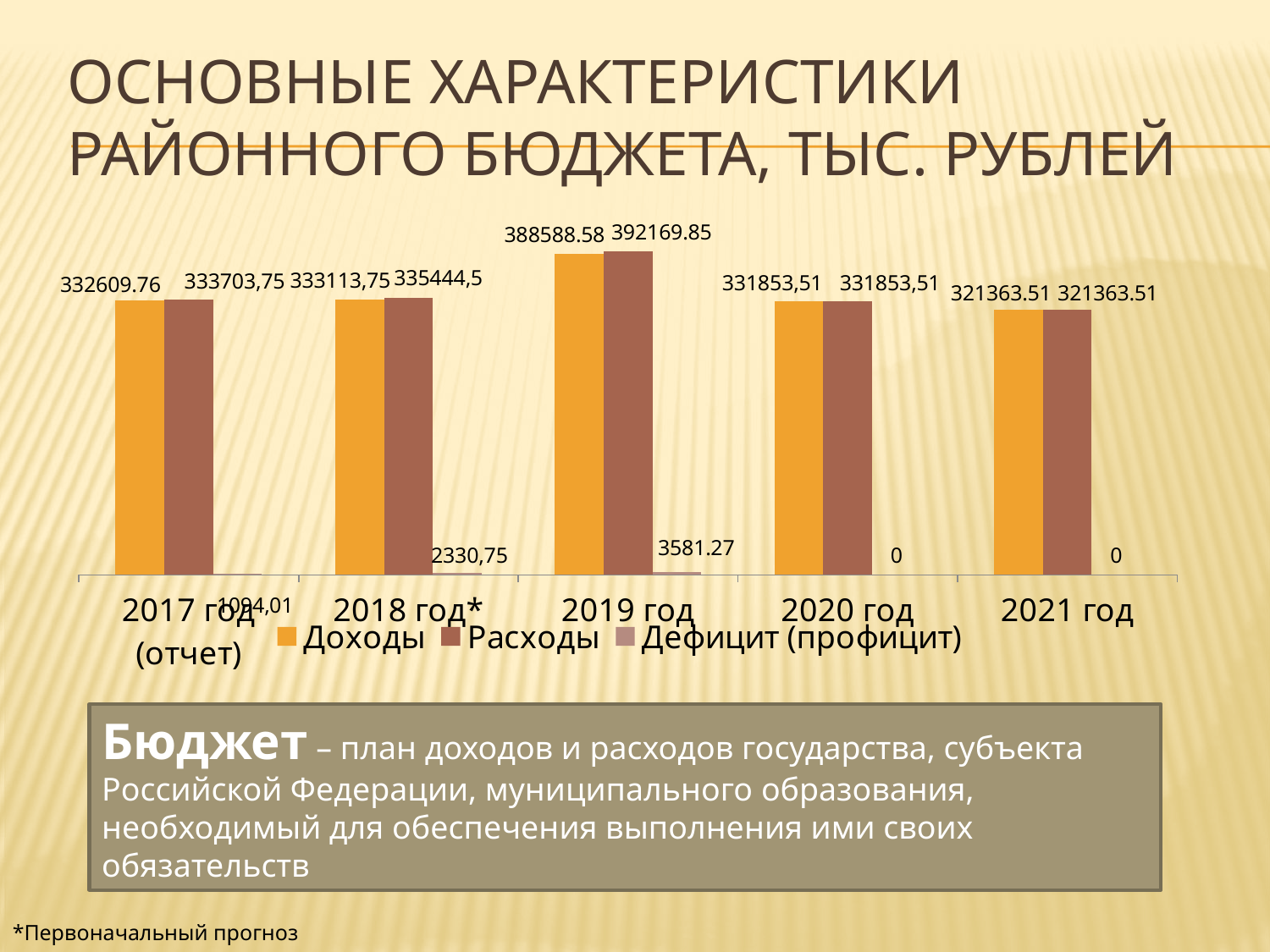
How many years (categories) are shown on the x axis? 5 What kind of chart is shown on the slide? Bar chart What is the value of Дефицит (профицит) for 2020 год? 0 What is the difference between Расходы and Доходы for 2019 год? 3581.27 What is the value of Доходы for 2021 год? 321363.51 How many series does the legend list? 3 What is the value of Расходы for 2018 год*? 335444,5 What is the value of Доходы for 2019 год? 388588.58 Which year has the lowest value of Расходы? 2021 год Which year has the highest value of Доходы? 2019 год For 2018 год*, which is larger: Доходы or Расходы? Расходы What is the value of Дефицит (профицит) for 2019 год? 3581.27